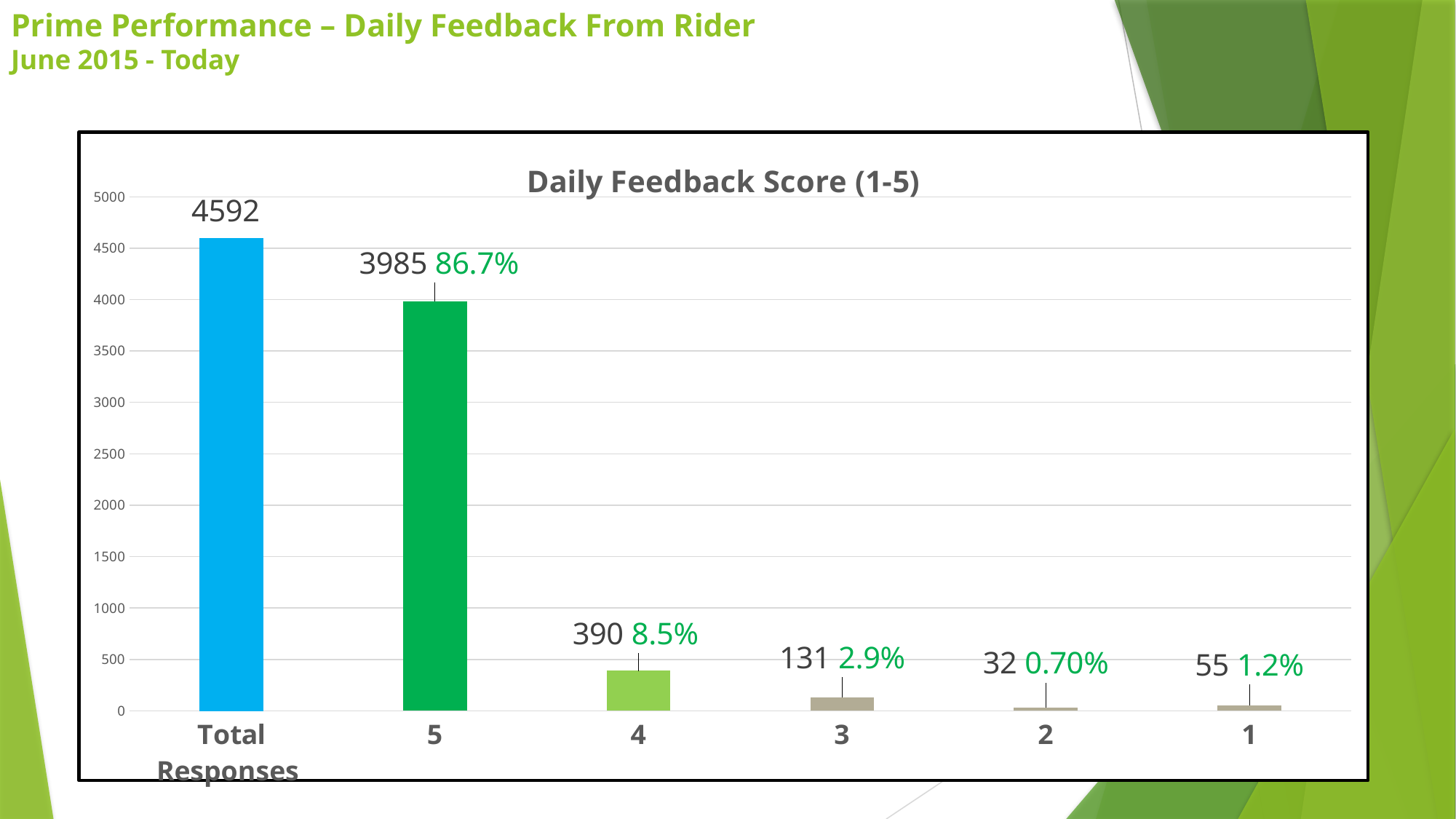
What is the difference between the number of responses for score 5 and score 4? 3595 What percentage is shown for score 4? 8.5% Which has more responses, score 1 or score 2? Score 1 What is the value for Total Responses? 4592 What percentage is shown for score 2? 0.70% What is the value for score 1? 55 How many bars are shown in the chart? 6 What is the value for score 3? 131 Among the scores 1 to 5, which score has the highest number of responses? 5 How many responses gave a score of 5? 3985 What is the title of the chart? Daily Feedback Score (1-5) Among the scores 1 to 5, which score has the lowest number of responses? 2